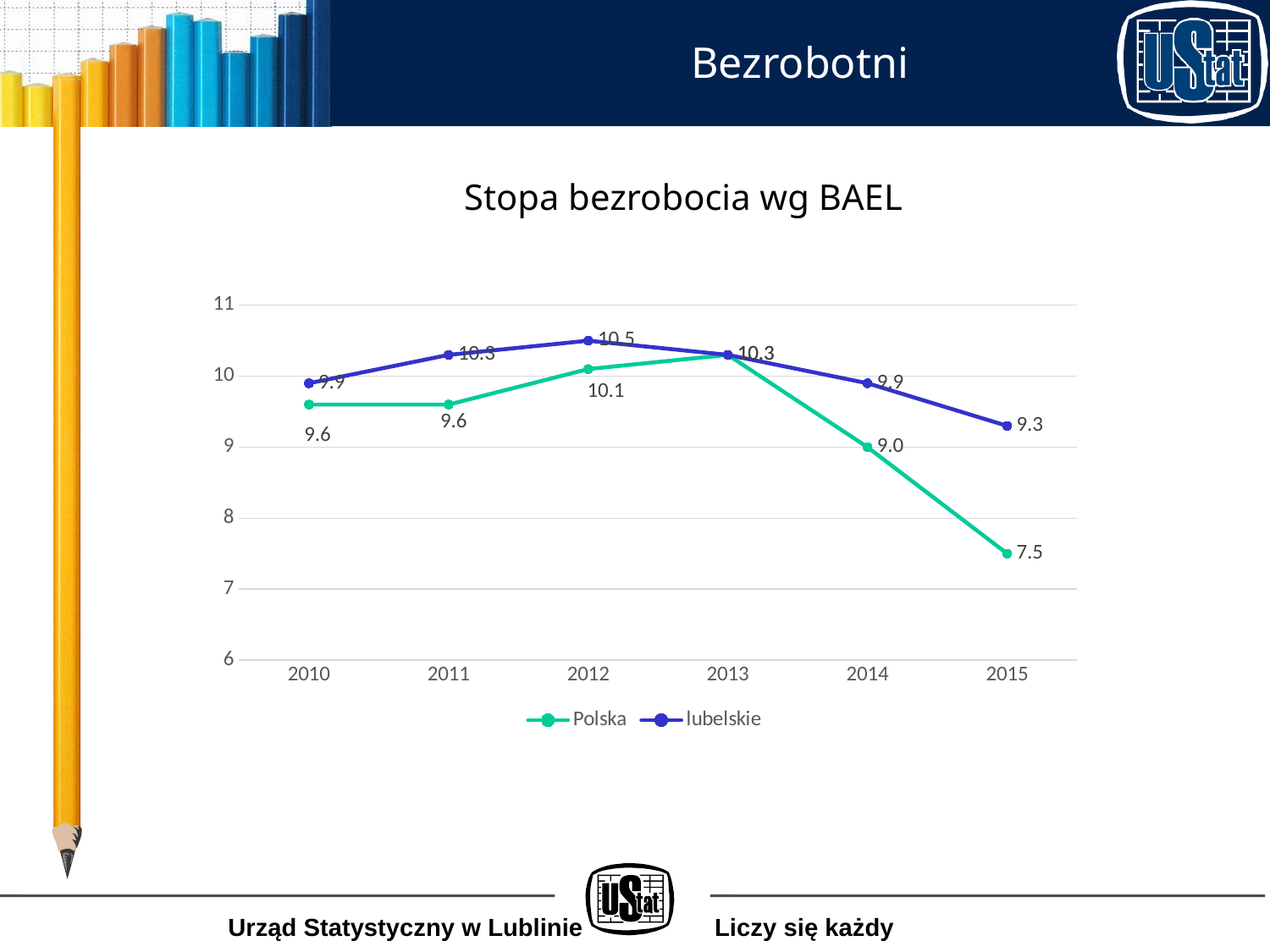
In which year is the Polska series lowest? 2015 What is the value for Polska in 2014? 9.0 What is the value for lubelskie in 2010? 9.9 What is the difference between lubelskie and Polska in 2015? 1.8 What is the value for Polska in 2015? 7.5 Which series has the higher value in 2014, Polska or lubelskie? lubelskie How many series does the legend list? 2 What is the value for lubelskie in 2012? 10.5 What is the title of the chart? Stopa bezrobocia wg BAEL What type of chart is shown on the slide? line chart In which year is the lubelskie series highest? 2012 How many years are shown on the x axis? 6